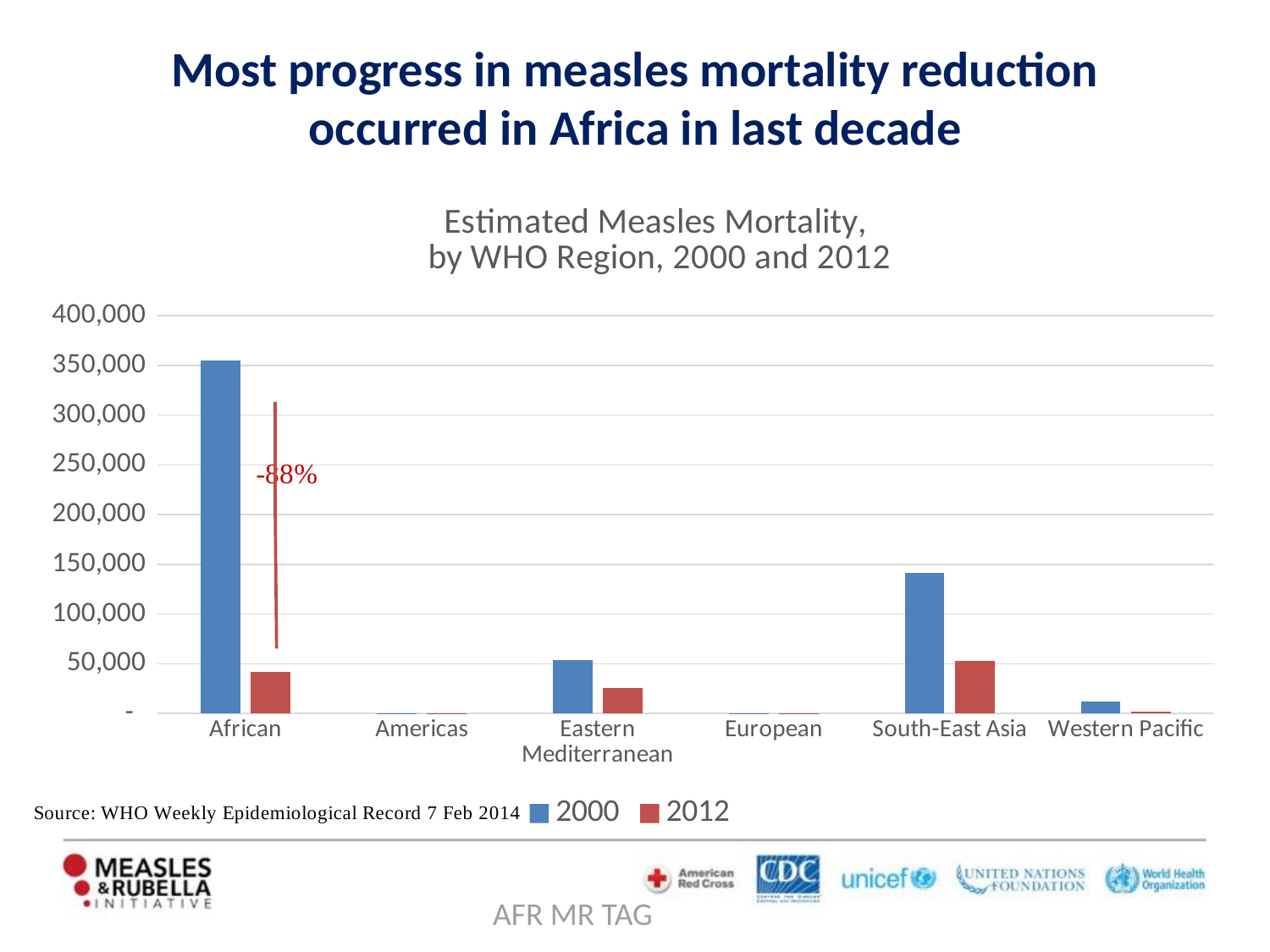
Which region has the highest estimated measles mortality for 2000? African Which two years are listed in the chart legend? 2000 and 2012 What kind of chart is shown on the slide? bar chart Which is larger, the 2000 value for the African region or the 2000 value for South-East Asia? African How many series does the chart legend list? 2 Is the 2000 value for Eastern Mediterranean greater or less than 100,000? less What percentage change is annotated next to the African region bars? -88% Is the 2000 value for South-East Asia greater or less than 100,000? greater Is the 2000 value for the African region greater or less than 300,000? greater How many WHO regions are shown on the x axis of the chart? 6 For the Eastern Mediterranean region, which year has the larger value, 2000 or 2012? 2000